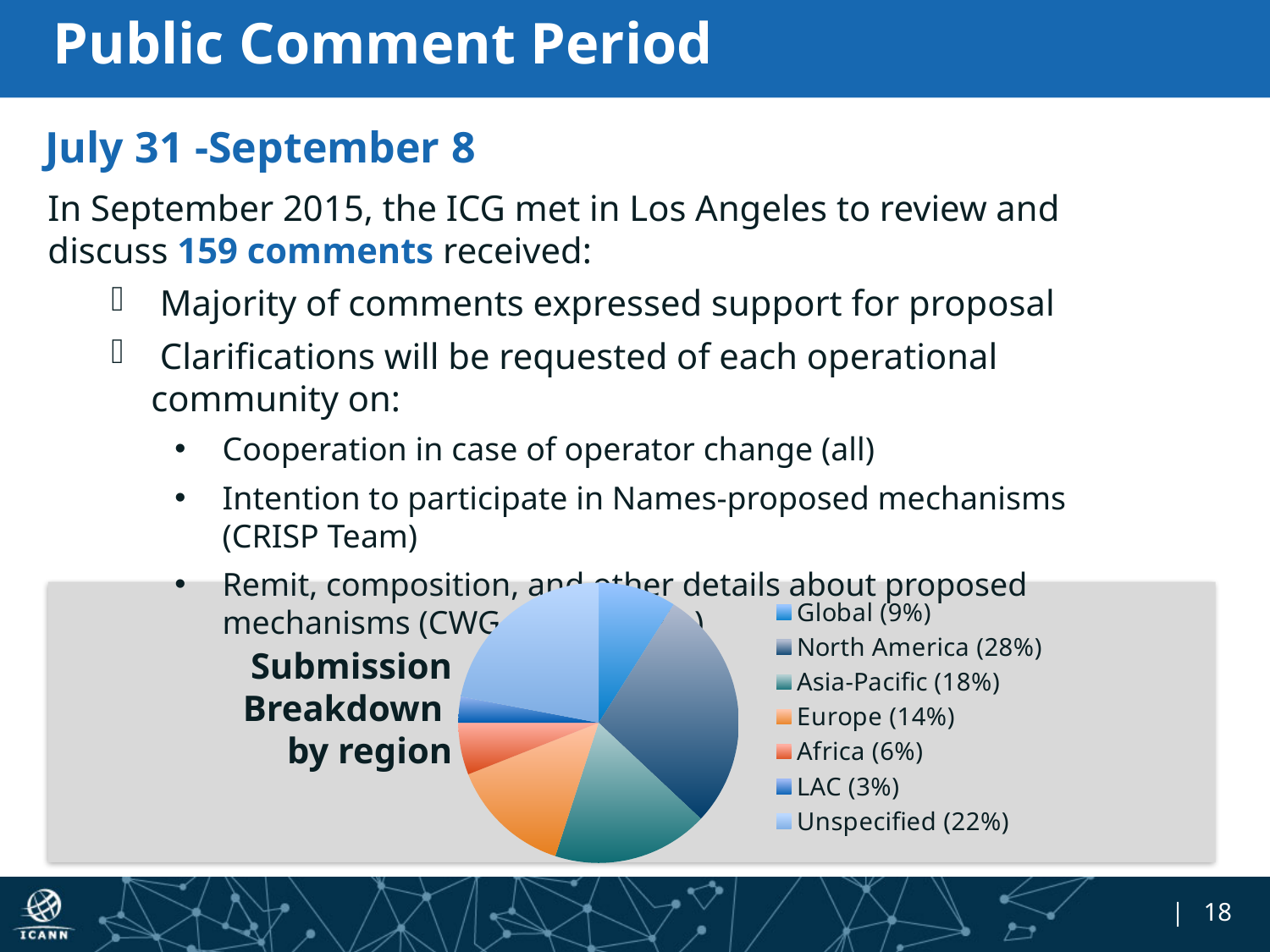
What kind of chart is shown on the slide? pie chart How many regions (slices) does the pie chart show? 7 What share of submissions came from North America? 28% Which region has the smallest share of submissions? LAC What share of submissions is listed as Unspecified? 22% What is the combined share of Africa and LAC? 9% Which region has the largest share of submissions? North America How many percentage points larger is North America's share than Europe's share? 14 What is the title of the pie chart? Submission Breakdown by region What share of submissions came from Europe? 14% What share of submissions came from Asia-Pacific? 18% Which has a larger share of submissions, Asia-Pacific or Global? Asia-Pacific